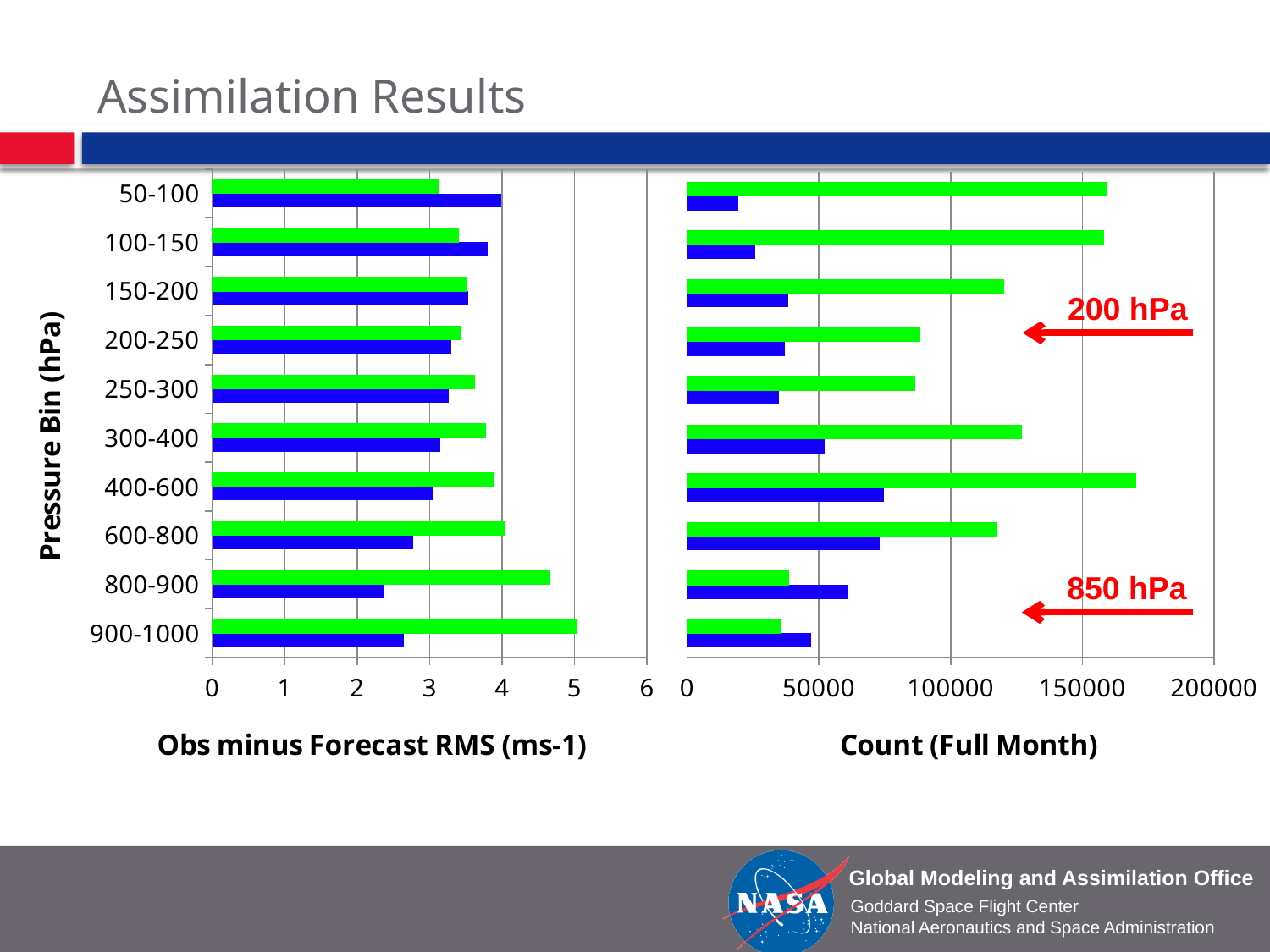
In the Obs minus Forecast RMS (ms-1) chart, is the green bar for 800-900 greater or less than 4? greater In the Obs minus Forecast RMS (ms-1) chart, for the 900-1000 bin, which bar is longer, green or blue? green In the Count (Full Month) chart, which pressure bin has the shortest blue bar? 50-100 In the Count (Full Month) chart, which pressure bin has the longest green bar? 400-600 In the Obs minus Forecast RMS (ms-1) chart, is the blue bar for 800-900 greater or less than 3? less What is the y-axis title shared by the two charts? Pressure Bin (hPa) What kind of chart is used on this slide for the Obs minus Forecast RMS and Count panels? Bar chart In the Obs minus Forecast RMS (ms-1) chart, which pressure bin has the longest green bar? 900-1000 In the Obs minus Forecast RMS (ms-1) chart, which pressure bin has the shortest blue bar? 800-900 How many pressure bins are shown on the y axis of the charts? 10 In the Count (Full Month) chart, is the green bar for 50-100 greater or less than 150000? greater How many data series (bar colours) are plotted in each chart? 2